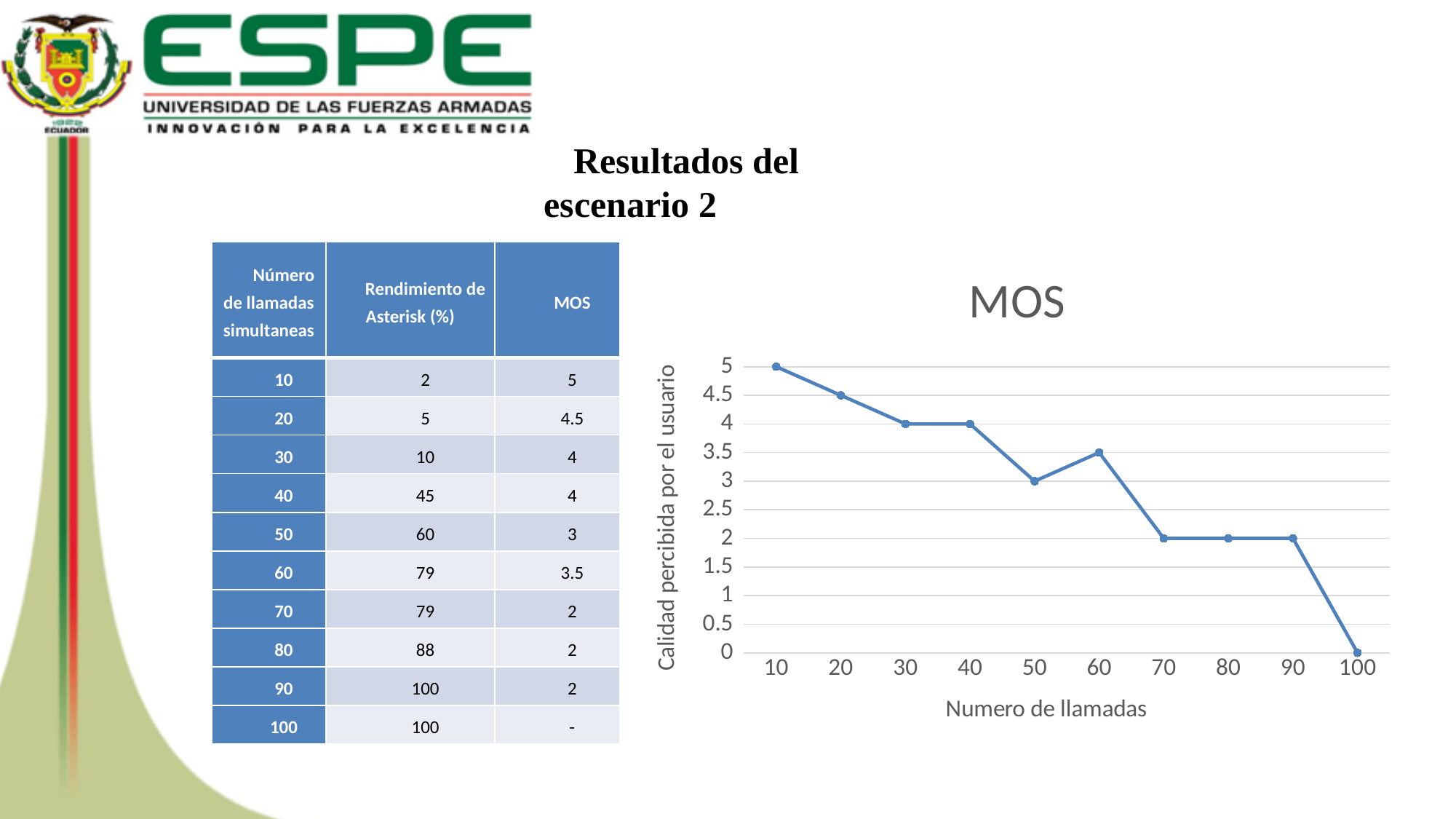
What is the MOS value at 50 calls in the MOS chart? 3 What is the MOS value at 20 calls in the MOS chart? 4.5 What is the MOS value at 10 calls in the MOS chart? 5 At which number of calls is the MOS lowest in the MOS chart? 100 At which number of calls is the MOS highest in the MOS chart? 10 What is the MOS value at 60 calls in the MOS chart? 3.5 What is the difference between the MOS at 10 calls and the MOS at 50 calls in the MOS chart? 2 What is the label of the y axis in the MOS chart? Calidad percibida por el usuario What kind of chart is the MOS chart? line chart What is the MOS value at 100 calls in the MOS chart? 0 Which has a higher MOS in the MOS chart, 50 calls or 60 calls? 60 calls How many data points are plotted in the MOS chart? 10